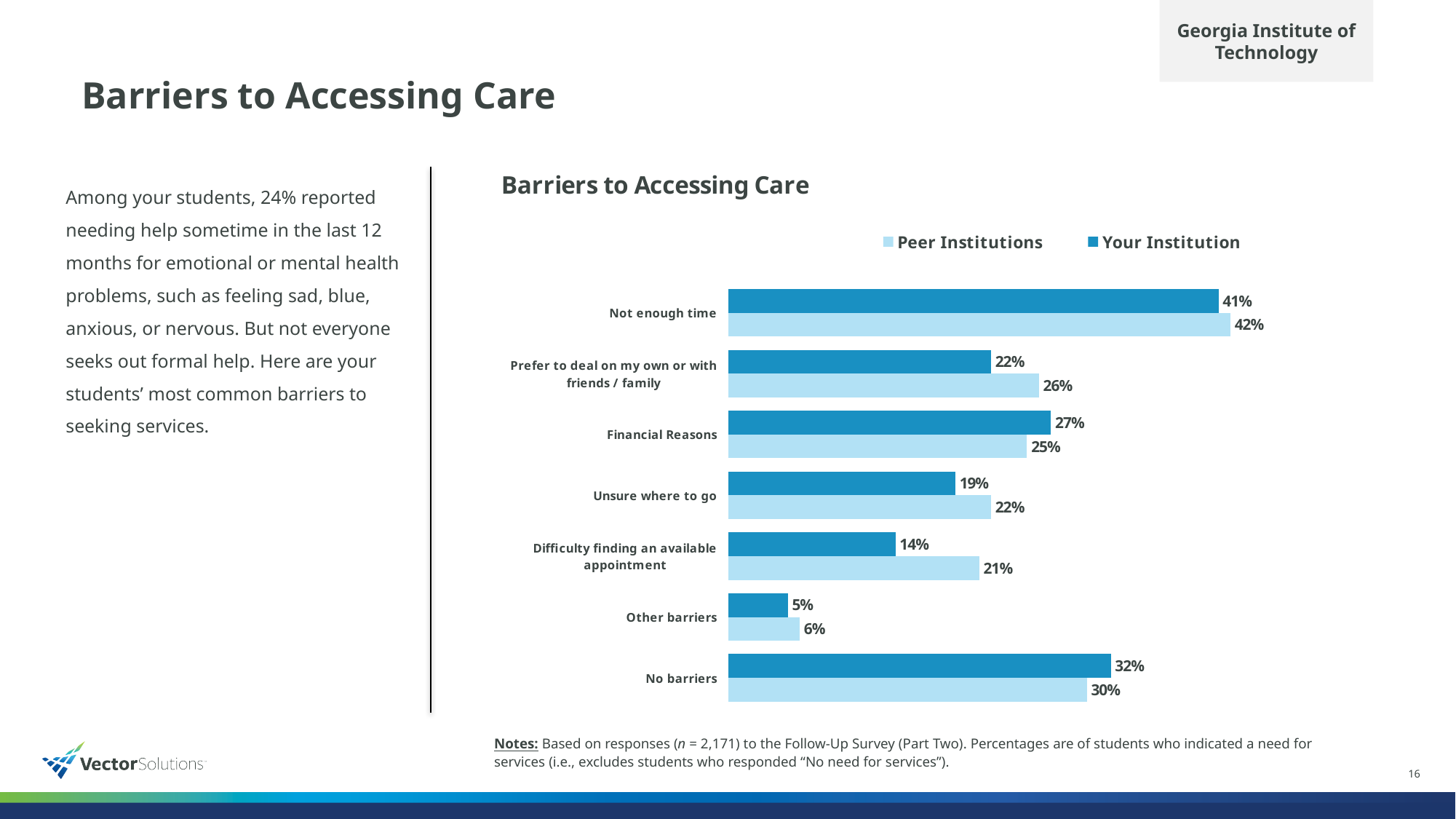
How many series does the legend list? 2 What is the value for Your Institution for "Not enough time"? 41% Which category has the highest value for Peer Institutions? Not enough time What kind of chart is shown on the slide? Bar chart Which category has the lowest value for Your Institution? Other barriers For "No barriers", which is larger: Peer Institutions or Your Institution? Your Institution What is the value for Your Institution for "No barriers"? 32% What is the difference between Peer Institutions and Your Institution for "Difficulty finding an available appointment"? 7% What is the value for Peer Institutions for "Difficulty finding an available appointment"? 21% How many barrier categories are shown in the chart? 7 For "Unsure where to go", which is larger: Peer Institutions or Your Institution? Peer Institutions What is the difference between Your Institution and Peer Institutions for "Financial Reasons"? 2%